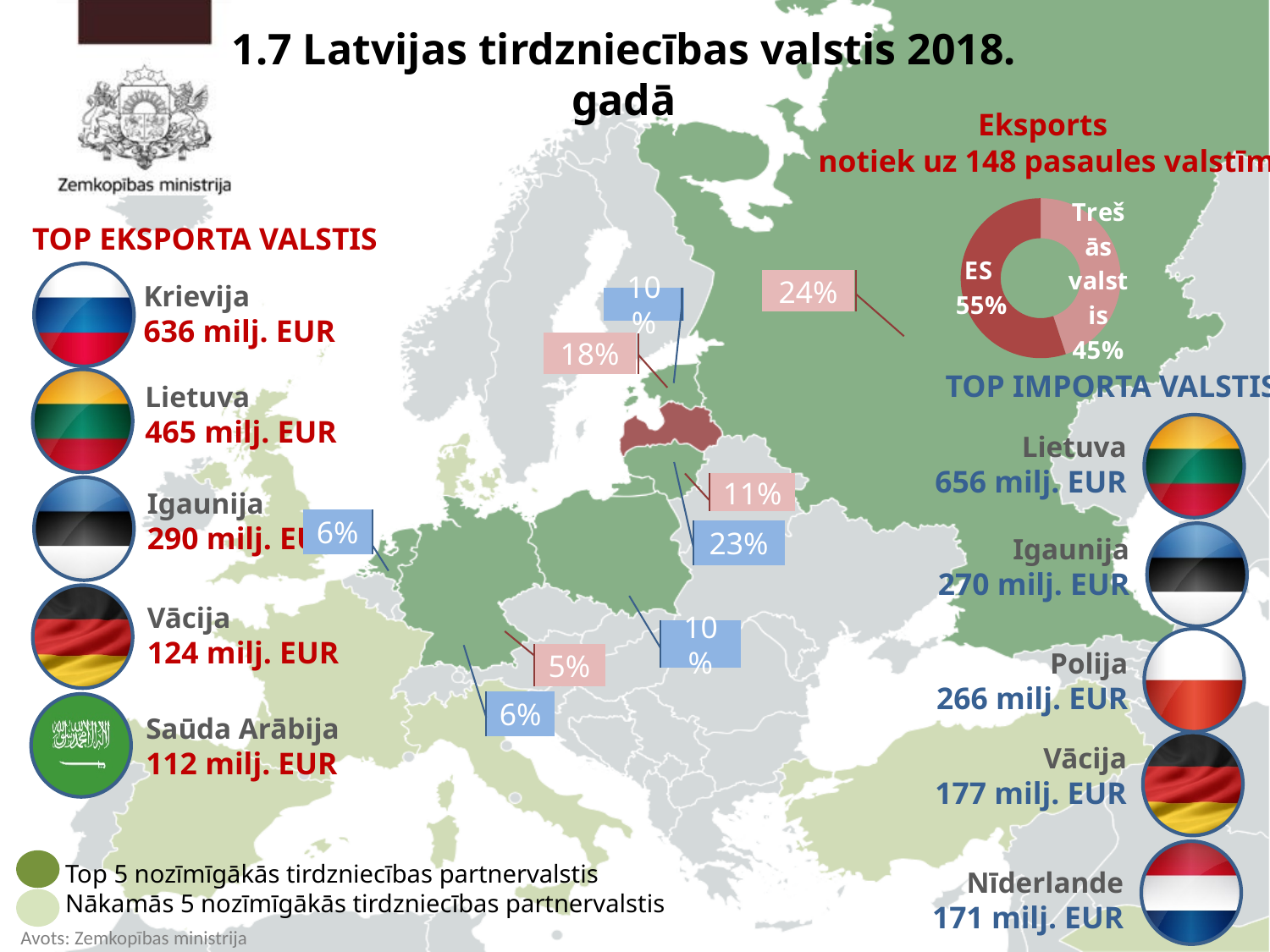
In the donut chart, which category has the smallest share? Trešās valstis In the donut chart, which category has the largest share? ES In the donut chart, is the ES share greater or less than 50%? greater In the donut chart, by how many percentage points does the ES share exceed the Trešās valstis share? 10 percentage points In the donut chart, which slice is larger, ES or Trešās valstis? ES What kind of chart is shown under the heading 'Eksports notiek uz 148 pasaules valstīm'? Pie (donut) chart According to the heading above the donut chart, to how many countries of the world do exports go? 148 In the donut chart, what share of exports goes to ES? 55% In the donut chart, which slice is drawn in the darker red colour? ES How many slices does the donut chart have? 2 In the donut chart, what share of exports goes to Trešās valstis? 45%